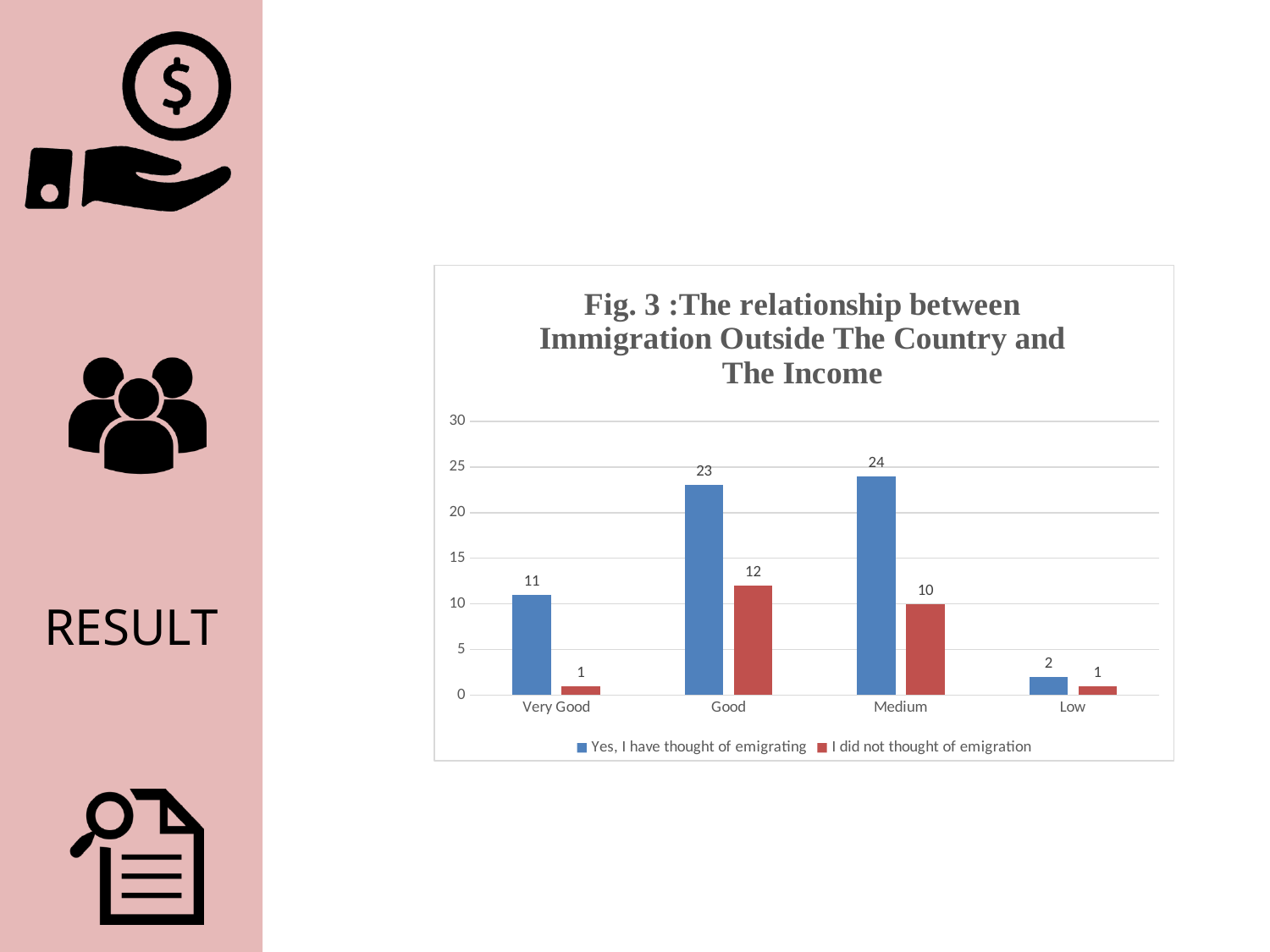
How many series does the legend list? 2 What is the value for "Yes, I have thought of emigrating" in the Good category? 23 How many income categories are shown on the x axis? 4 Is the value for "Yes, I have thought of emigrating" in the Medium category greater or less than 20? greater What is the value for "I did not thought of emigration" in the Medium category? 10 Which category has the lowest value for "Yes, I have thought of emigrating"? Low What is the difference between the two series in the Very Good category? 10 Which category has the highest value for "Yes, I have thought of emigrating"? Medium What is the value for "Yes, I have thought of emigrating" in the Very Good category? 11 In the Good category, which series has the larger value? Yes, I have thought of emigrating What is the title of the chart? Fig. 3 :The relationship between Immigration Outside The Country and The Income What kind of chart is shown on the slide? bar chart